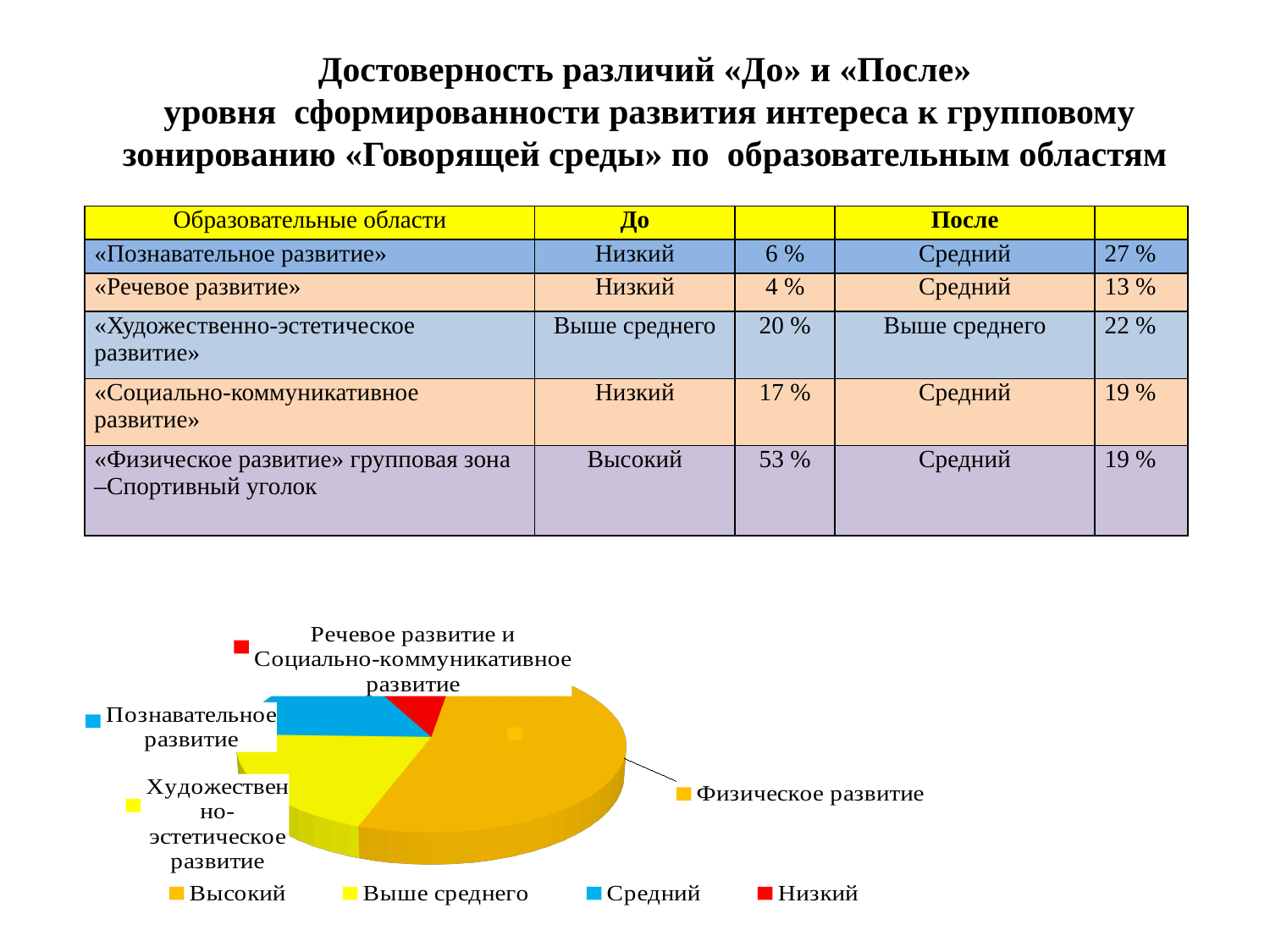
Which legend entry in the pie chart is shown in red? Низкий Which slice of the pie chart is the smallest? Речевое развитие и Социально-коммуникативное развитие How many slices does the pie chart have? 4 What kind of chart is shown at the bottom of the slide? pie chart Which slice of the pie chart is the largest? Физическое развитие How many entries does the pie chart's legend list? 4 In the pie chart, which slice is larger: Физическое развитие or Познавательное развитие? Физическое развитие In the pie chart, which slice is larger: Художественно-эстетическое развитие or Речевое развитие и Социально-коммуникативное развитие? Художественно-эстетическое развитие In the pie chart, which slice is larger: Физическое развитие or Художественно-эстетическое развитие? Физическое развитие What colour is the Физическое развитие slice in the pie chart? orange